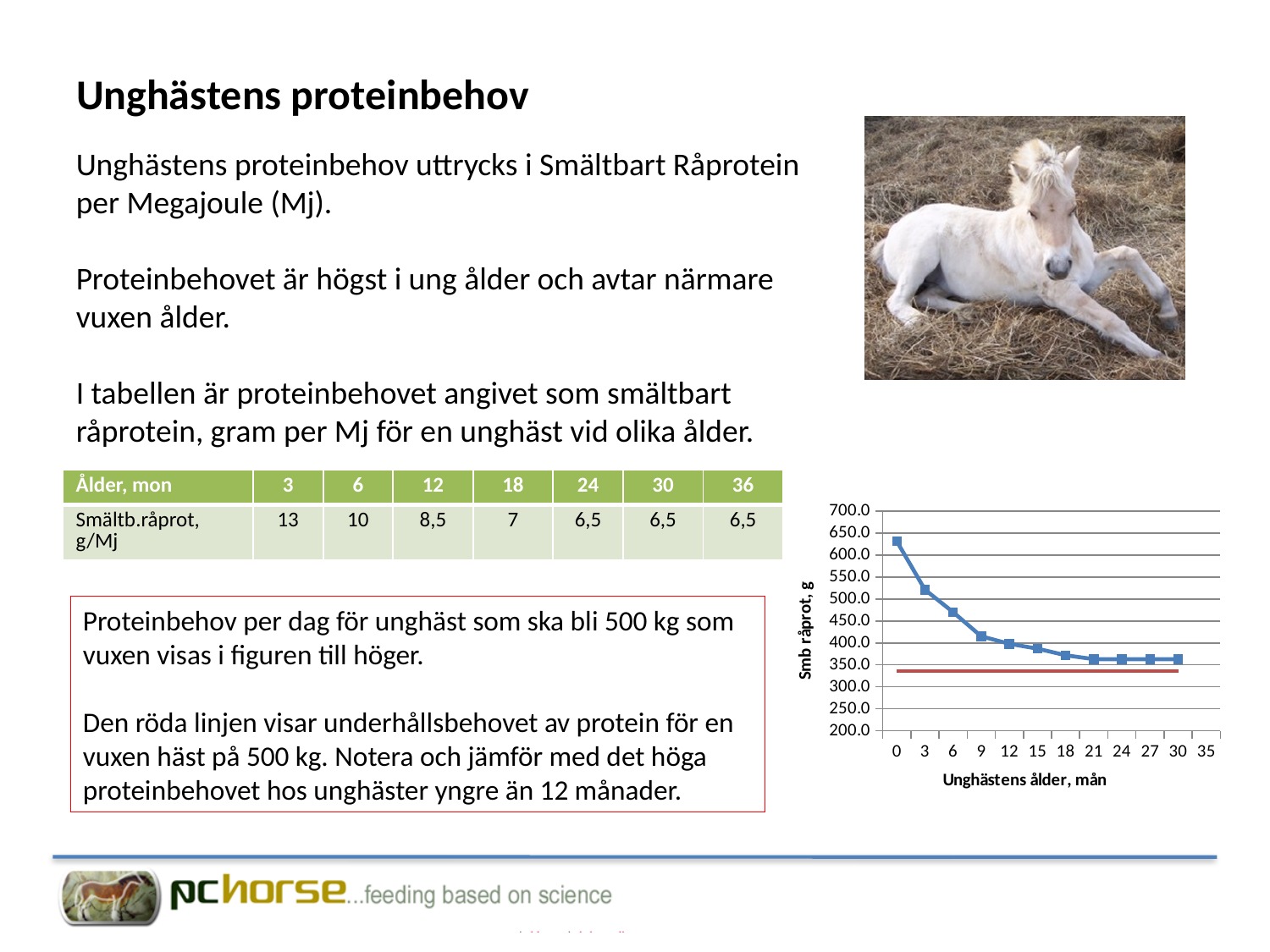
What is the title of the x axis of the chart? Unghästens ålder, mån What is the title of the y axis of the chart? Smb råprot, g Is the value of the blue line at age 3 months greater or less than 500? greater How many data points are plotted on the blue line? 11 Is the value of the blue line at age 30 months greater or less than 400? less Which is larger, the value of the blue line at age 0 months or at age 30 months? age 0 months What kind of chart is shown on the slide? line chart Is the red line greater or less than 350 on the y axis? less At which age (in months) is the blue line at its highest value? 0 Do the values of the blue line rise or fall as the horse's age increases along the x axis? fall